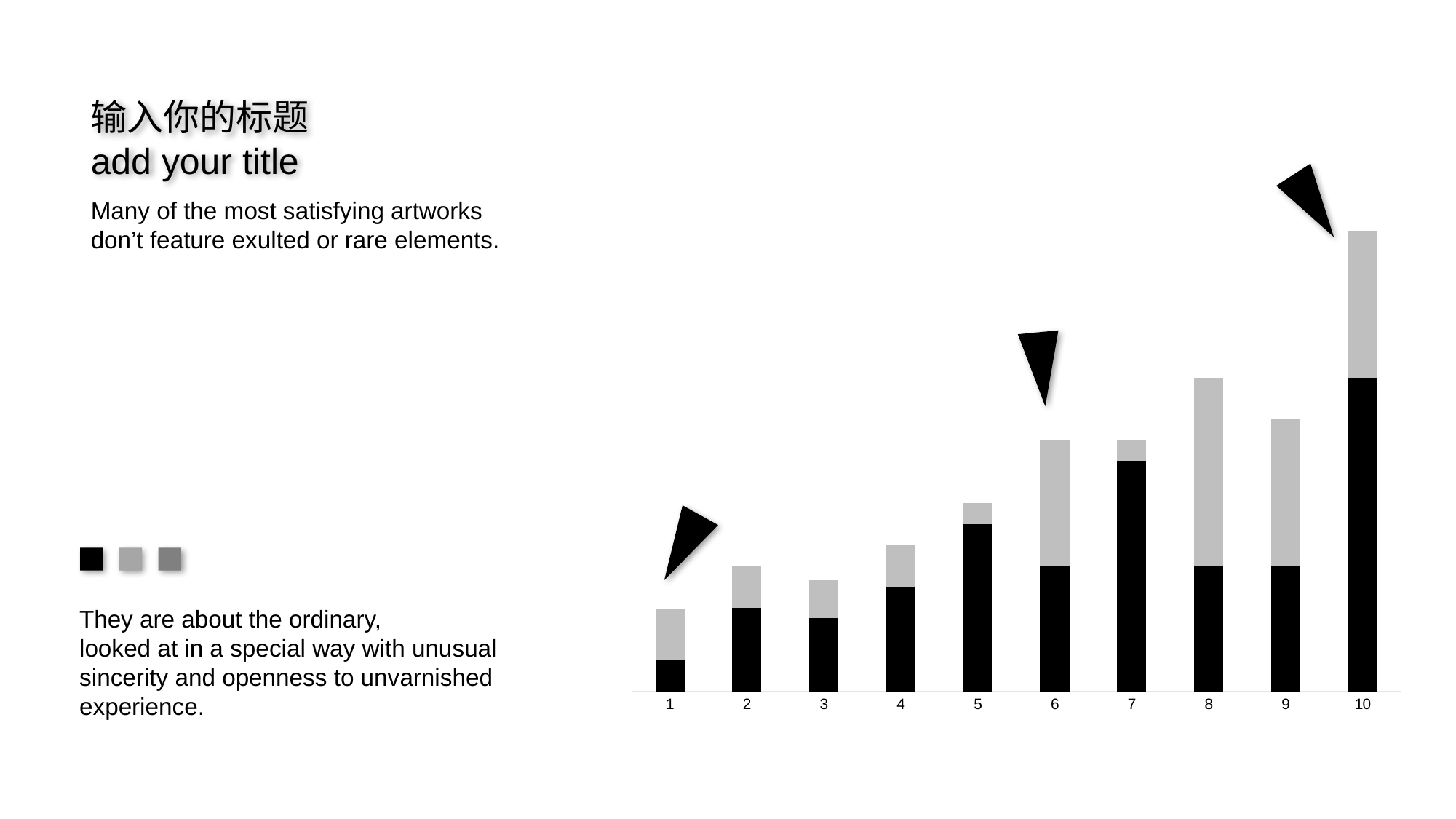
Which category has the smallest gray (top) segment? 5 and 7 (tied) What colour is the bottom segment of each stacked bar? black Which category has the smallest black (bottom) segment? 1 Which bar is taller overall, category 10 or category 1? 10 Which category has the tallest bar overall? 10 Which category has the shortest bar overall? 1 Which bar is taller overall, category 8 or category 6? 8 Do the total bar heights generally rise or fall from category 1 to category 10? rise Which category has the largest gray (top) segment? 8 What kind of chart is shown on the slide? stacked bar chart How many categories are shown on the x axis of the chart? 10 Which category has the largest black (bottom) segment? 10